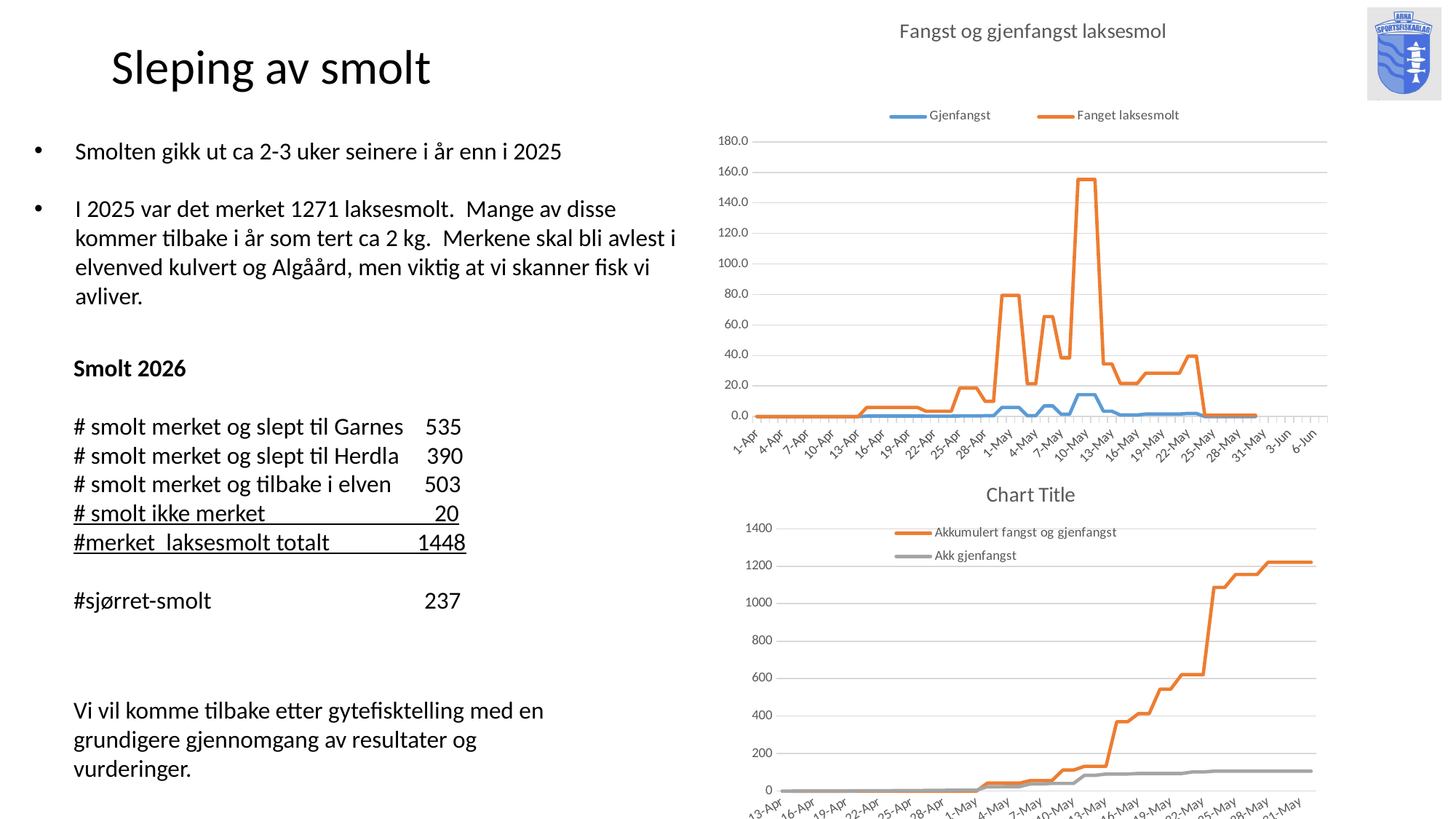
In the bottom chart titled 'Chart Title', what kind of chart is shown? Line chart In the bottom chart titled 'Chart Title', is the value of 'Akkumulert fangst og gjenfangst' at 31-May greater or less than 1000? greater In the chart titled 'Fangst og gjenfangst laksesmol', what kind of chart is shown? Line chart In the bottom chart titled 'Chart Title', how many series does the legend list? 2 In the bottom chart titled 'Chart Title', does the 'Akkumulert fangst og gjenfangst' series rise or fall from 13-Apr to 31-May? Rises In the bottom chart titled 'Chart Title', is the value of 'Akk gjenfangst' at 31-May greater or less than 200? less In the chart titled 'Fangst og gjenfangst laksesmol', how many series does the legend list? 2 In the chart titled 'Fangst og gjenfangst laksesmol', what are the two legend entries? Gjenfangst and Fanget laksesmolt In the chart titled 'Fangst og gjenfangst laksesmol', is the value of Fanget laksesmolt on 1-Apr greater or less than 20? less In the chart titled 'Fangst og gjenfangst laksesmol', which series reaches the higher peak, Gjenfangst or Fanget laksesmolt? Fanget laksesmolt